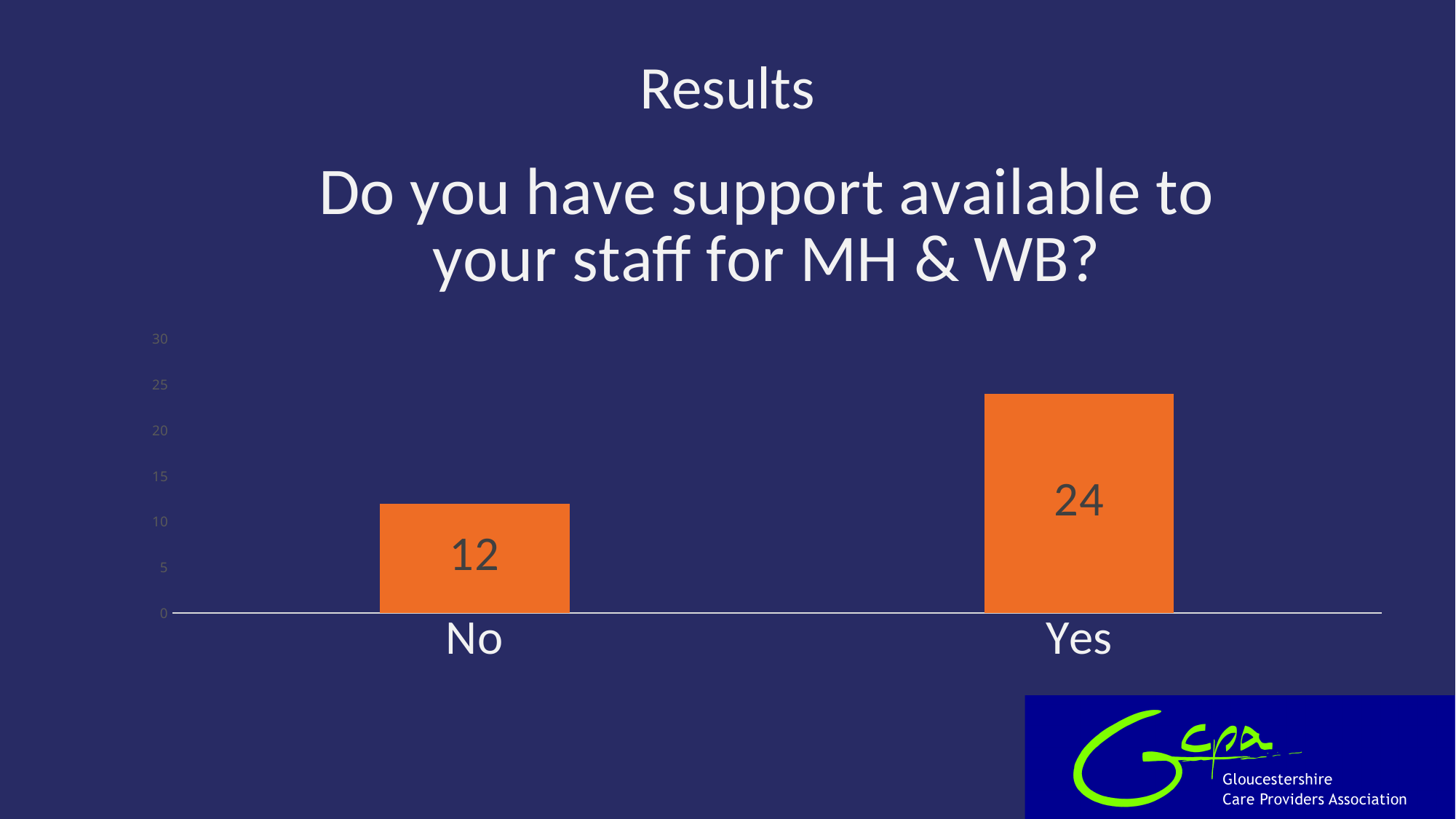
Which is larger, the value for Yes or the value for No? Yes What is the difference between the values for Yes and No? 12 Which category has the lowest value? No What is the total of the values for No and Yes? 36 What is the value for No? 12 Is the value for No greater or less than 15? less Which category has the highest value? Yes What kind of chart is shown on the slide? bar chart What is the value for Yes? 24 Is the value for Yes greater or less than 20? greater What question does the chart present results for? Do you have support available to your staff for MH & WB? How many categories are shown on the chart? 2